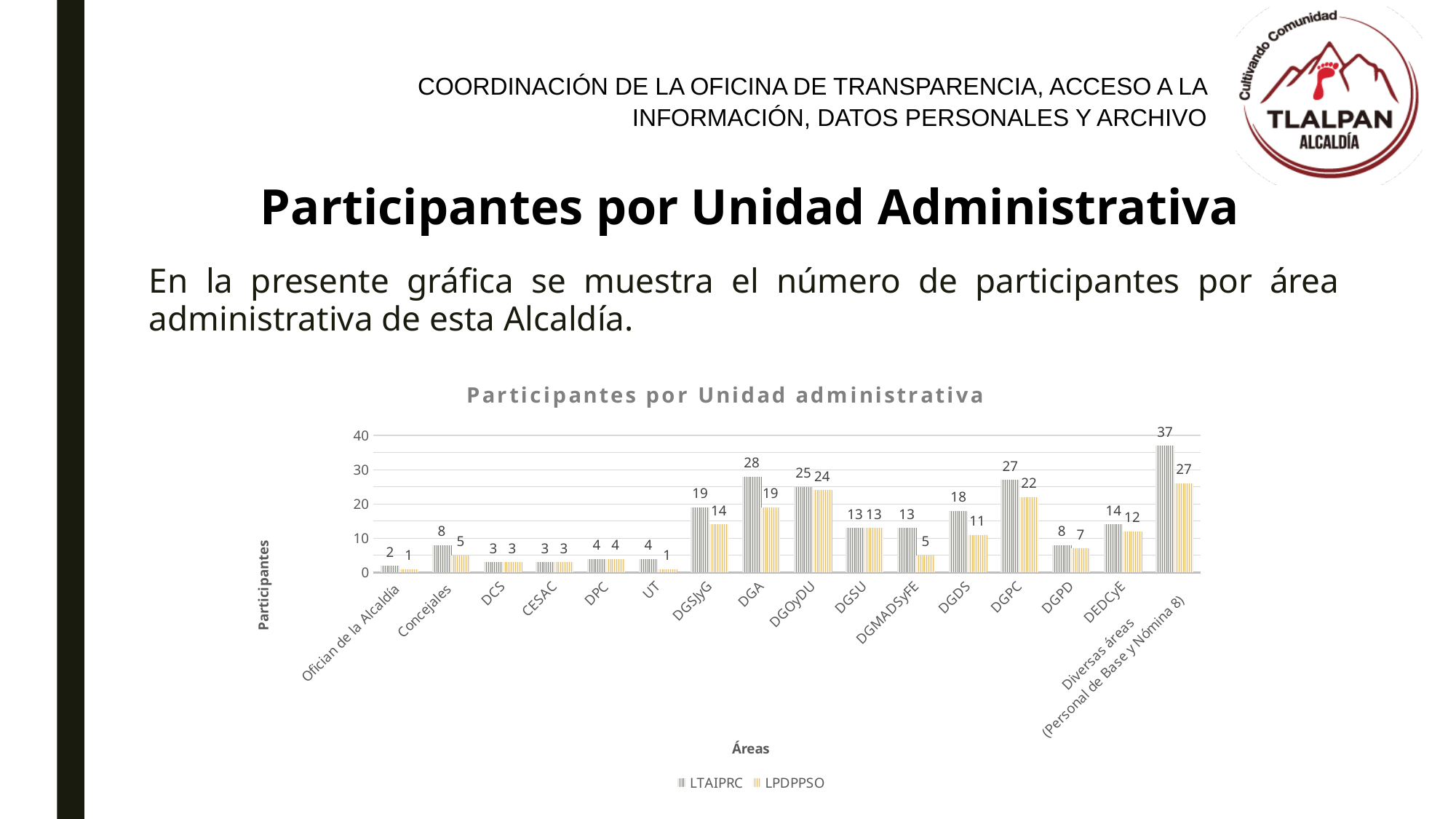
How many series does the legend list? 2 What kind of chart is shown? bar chart Which is larger for DGOyDU: the LTAIPRC value or the LPDPPSO value? LTAIPRC What is the title of the chart? Participantes por Unidad administrativa Which category has the highest LTAIPRC value? Diversas áreas (Personal de Base y Nómina 8) What is the difference between the LTAIPRC and LPDPPSO values for DGMADSyFE? 8 How many categories (áreas) are shown on the x axis? 16 What is the LPDPPSO value for DGPC? 22 What is the LTAIPRC value for Concejales? 8 What is the LTAIPRC value for DGA? 28 Which category has the lowest LPDPPSO value? Ofician de la Alcaldía and UT (both 1) Is the LTAIPRC value for DGDS greater or less than 20? less